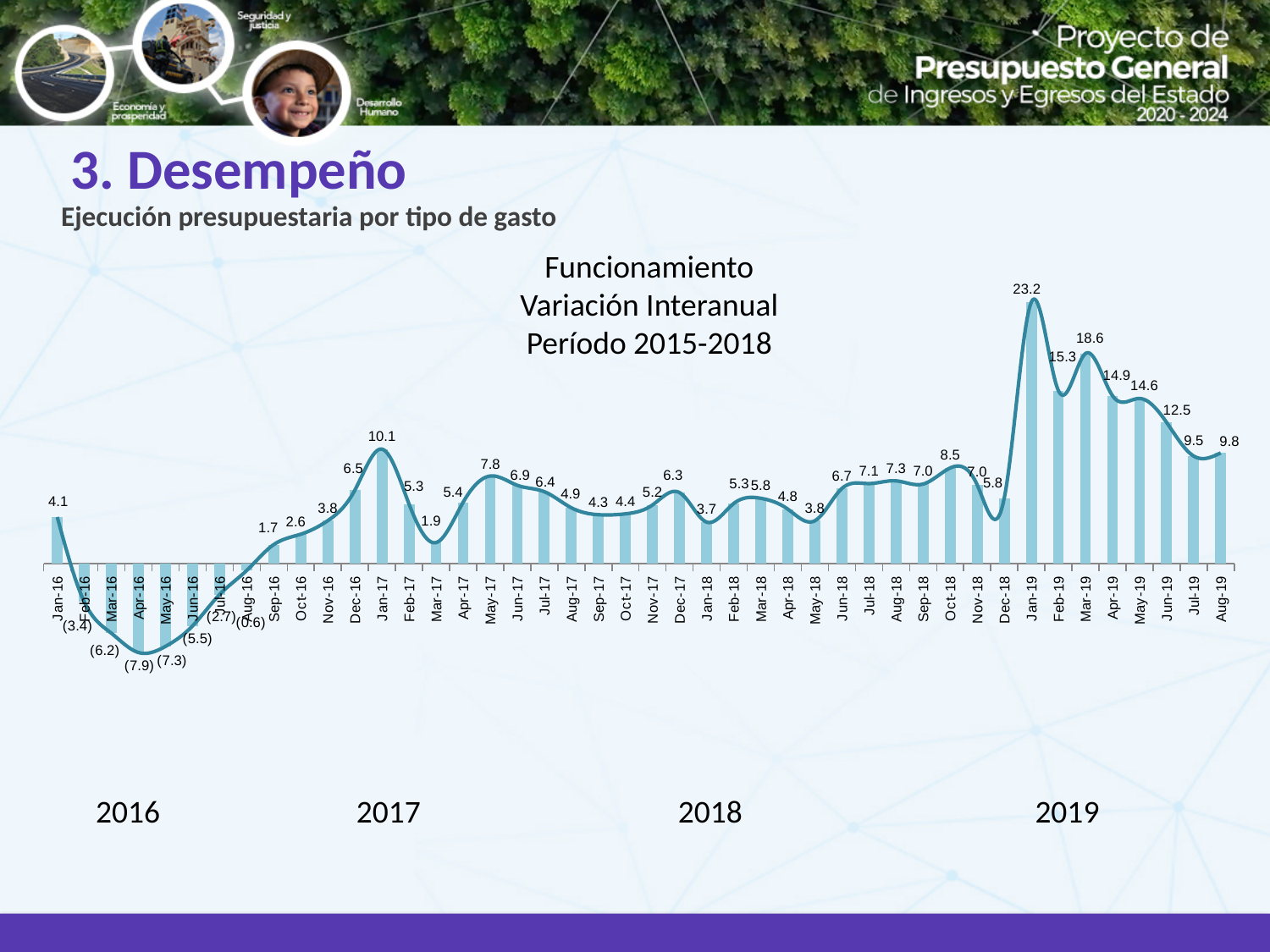
What kind of chart is this? combination bar and line chart What is the value for Mar-17? 1.9 What is the value for Oct-18? 8.5 Do the values rise or fall from Jan-19 to Aug-19? fall What is the value for Jan-19? 23.2 Which month has the lowest value? Apr-16 What is the difference between the values for Jan-19 and Feb-19? 7.9 How many months are plotted on the chart? 44 What is the value for Apr-16? (7.9) Which month has the highest value? Jan-19 Which is larger, the value for Dec-16 or the value for Jan-17? Jan-17 What is the difference between the values for Mar-19 and Apr-19? 3.7